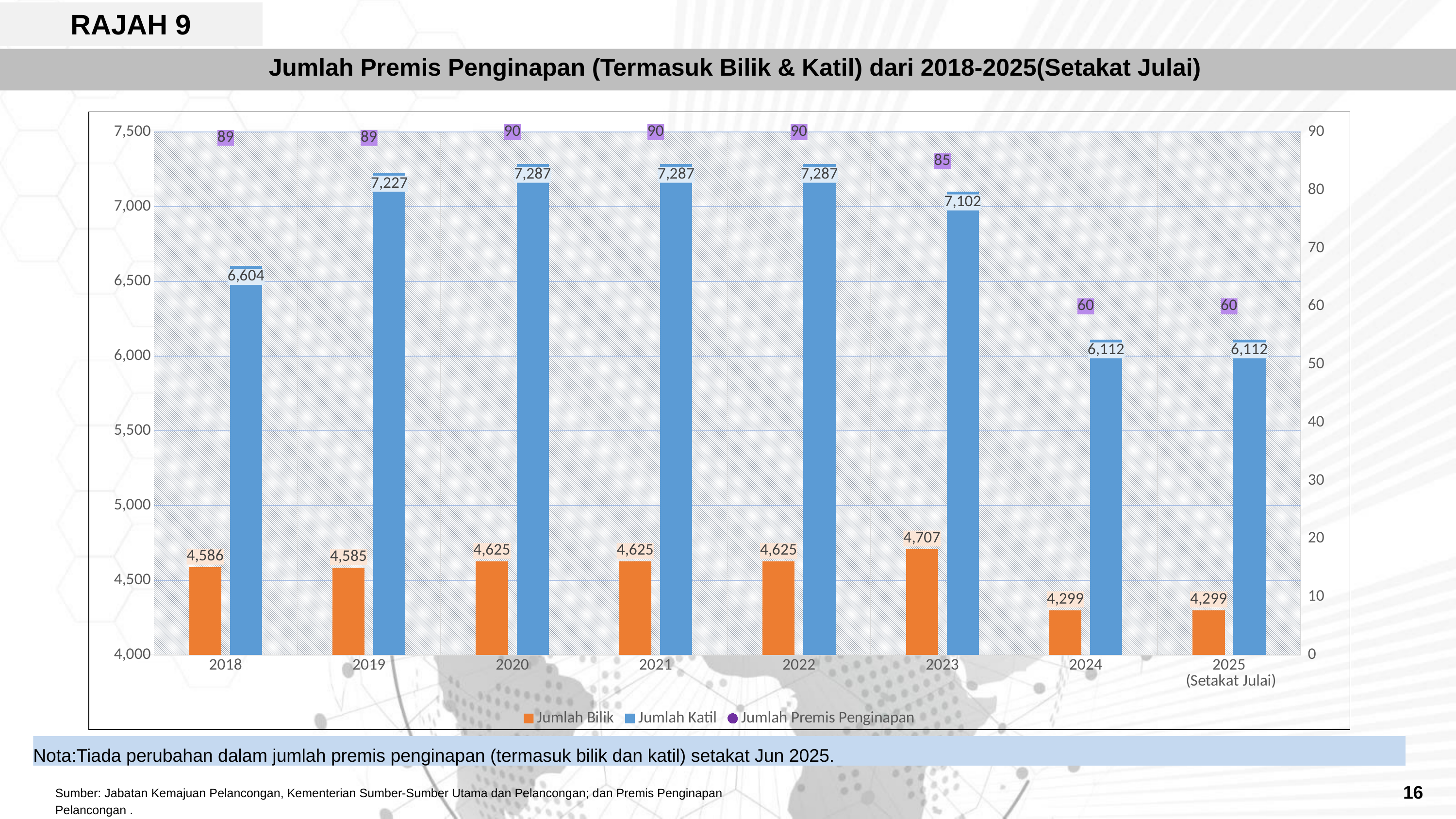
How many series does the legend list? 3 How many years are shown on the x axis? 8 Does Jumlah Premis Penginapan rise or fall from 2022 to 2025? fall What is the lowest value shown for Jumlah Premis Penginapan? 60 Which year has the larger Jumlah Katil, 2018 or 2019? 2019 What is the difference between Jumlah Katil in 2023 and in 2024? 990 What is the highest value shown for Jumlah Katil? 7,287 What is the value of Jumlah Katil for 2018? 6,604 In which year is Jumlah Bilik highest? 2023 What is the value of Jumlah Bilik for 2023? 4,707 What is the difference between Jumlah Bilik in 2023 and in 2024? 408 What is the value of Jumlah Premis Penginapan for 2024? 60